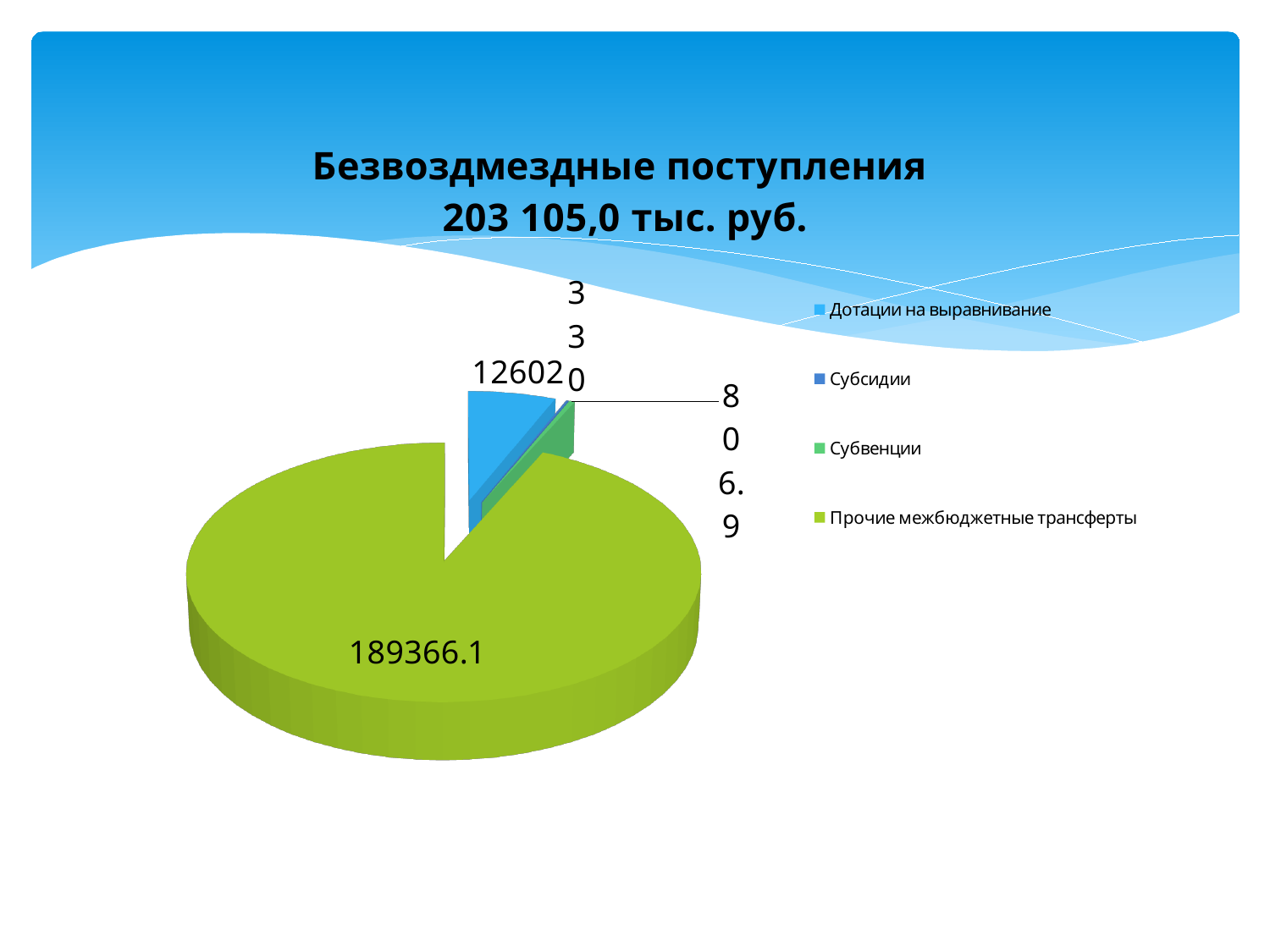
What is the value for Субсидии? 330 What is the title of the chart? Безвоздмездные поступления 203 105,0 тыс. руб. What is the value for Субвенции? 806.9 What is the value for Дотации на выравнивание? 12602 How many slices does the pie chart have? 4 What kind of chart is shown on the slide? pie chart What is the difference between the values for Прочие межбюджетные трансферты and Дотации на выравнивание? 176764.1 What is the value for Прочие межбюджетные трансферты? 189366.1 How many entries does the legend list? 4 Which category has the largest slice of the pie? Прочие межбюджетные трансферты Which is larger, the value for Дотации на выравнивание or the value for Субвенции? Дотации на выравнивание Which category has the smallest slice of the pie? Субсидии